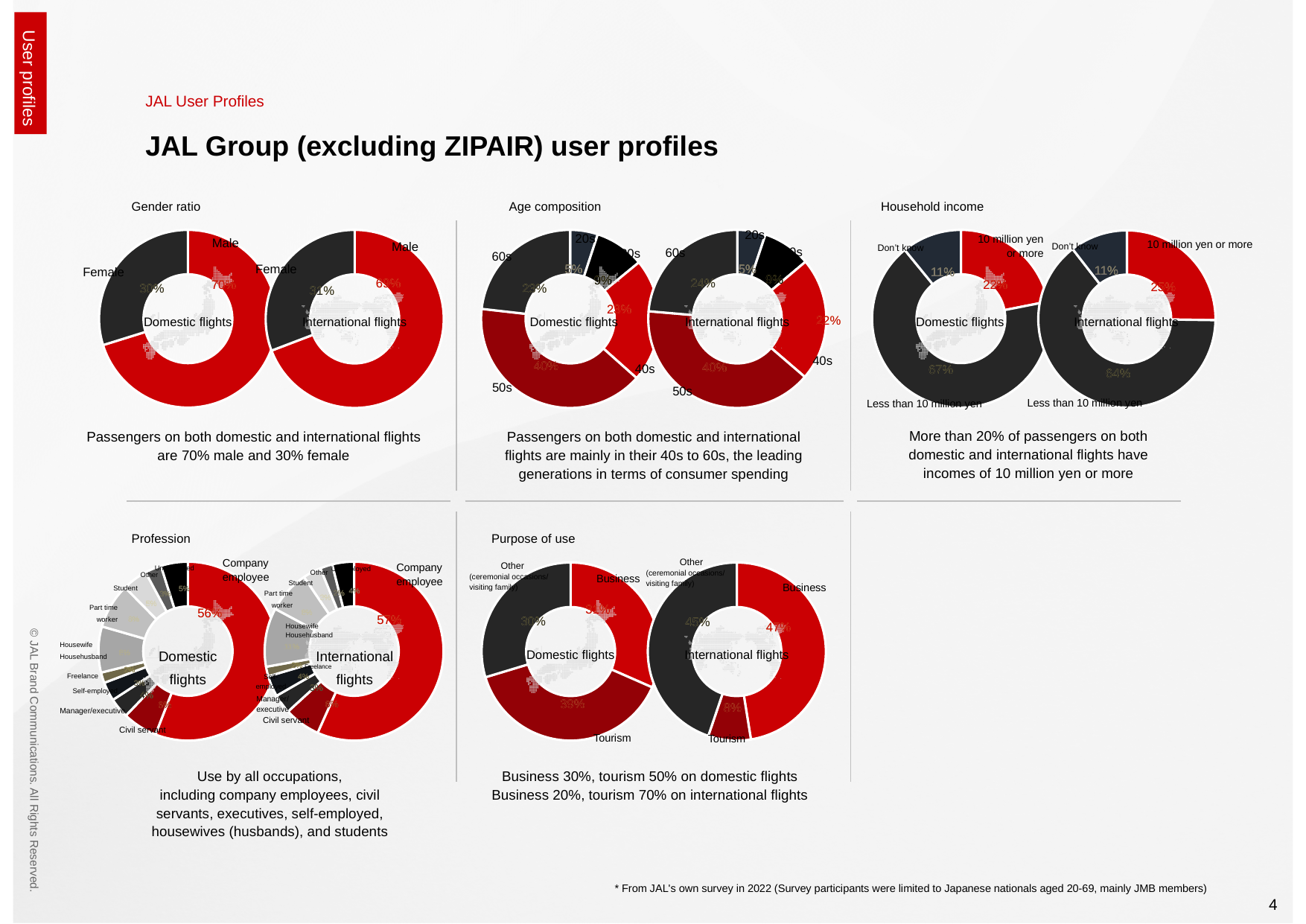
In the Household income chart for Domestic flights, what share of passengers have incomes of less than 10 million yen? 67% How many categories does each Household income chart show? 3 What kind of chart is used for the Gender ratio? Pie (donut) chart In the Household income charts, which has a larger share of passengers with 10 million yen or more: Domestic flights or International flights? International flights In the Household income chart for Domestic flights, which income category is the largest? Less than 10 million yen In the Gender ratio chart for Domestic flights, what percentage of passengers are Male? 70% In the Household income chart for International flights, what share of passengers answered 'Don't know'? 11% In the Household income chart for International flights, what share of passengers have incomes of 10 million yen or more? 25% In the Gender ratio chart for International flights, what percentage of passengers are Female? 31% In the Profession chart for Domestic flights, what share of passengers are company employees? 56% In the Age composition chart for International flights, what share of passengers are in their 60s? 24% In the Gender ratio chart for Domestic flights, what is the difference between the Male and Female shares? 40%